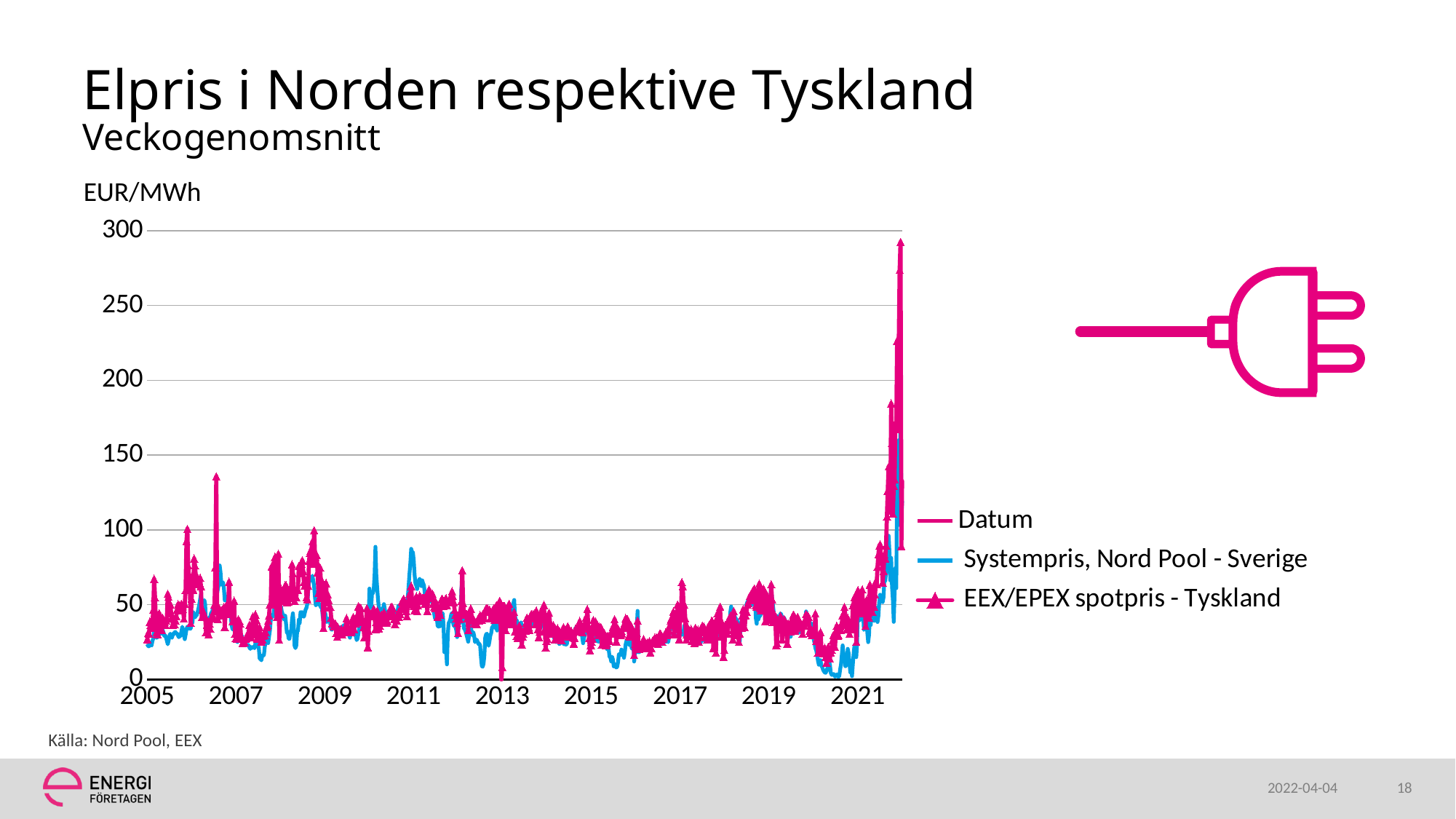
Is the value of Systempris, Nord Pool - Sverige during 2020 greater or less than 50? less Is the peak value of EEX/EPEX spotpris - Tyskland in late 2021 greater or less than 250? greater Is the peak value of Systempris, Nord Pool - Sverige in late 2021 greater or less than 100? greater What unit is shown above the vertical axis? EUR/MWh Which series reaches the highest value on the chart? EEX/EPEX spotpris - Tyskland How many year labels are shown on the horizontal axis? 9 What kind of chart is shown on the slide? Line chart What is the highest value shown on the vertical axis? 300 Do the prices rise or fall from 2020 to the end of 2021? Rise How many series does the legend list? 3